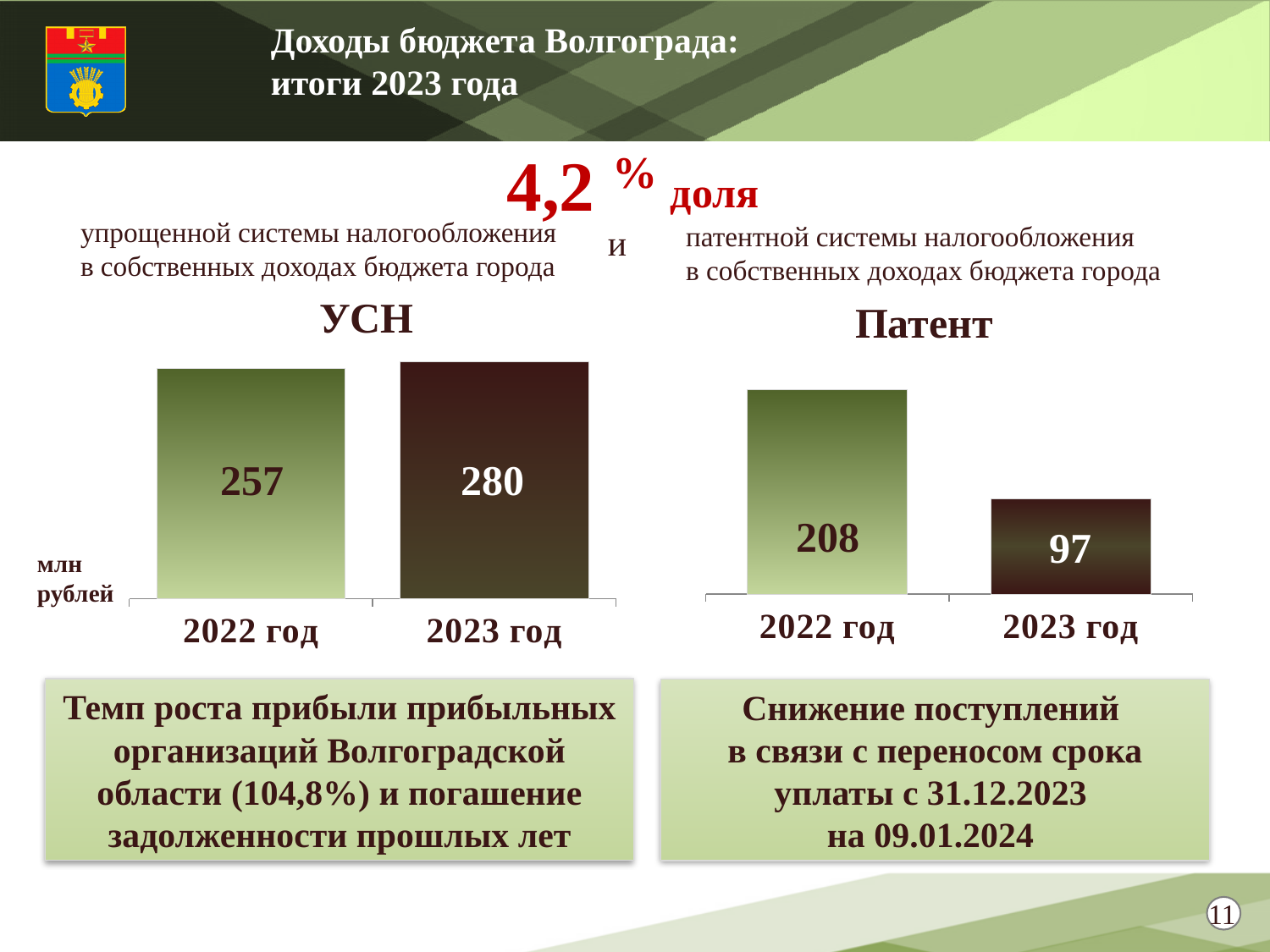
In the Патент chart, what is the value for 2023 год? 97 In the УСН chart, do the values rise or fall from 2022 год to 2023 год? rise In the Патент chart, what is the value for 2022 год? 208 How many bars does the Патент chart have? 2 In the УСН chart, what is the difference between the 2023 год and 2022 год values? 23 In the УСН chart, which year has the higher value? 2023 год In the УСН chart, what is the value for 2022 год? 257 In the Патент chart, which year has the lower value? 2023 год What kind of chart is the УСН chart? bar chart In the Патент chart, do the values rise or fall from 2022 год to 2023 год? fall In the Патент chart, what is the difference between the 2022 год and 2023 год values? 111 In the УСН chart, what is the value for 2023 год? 280